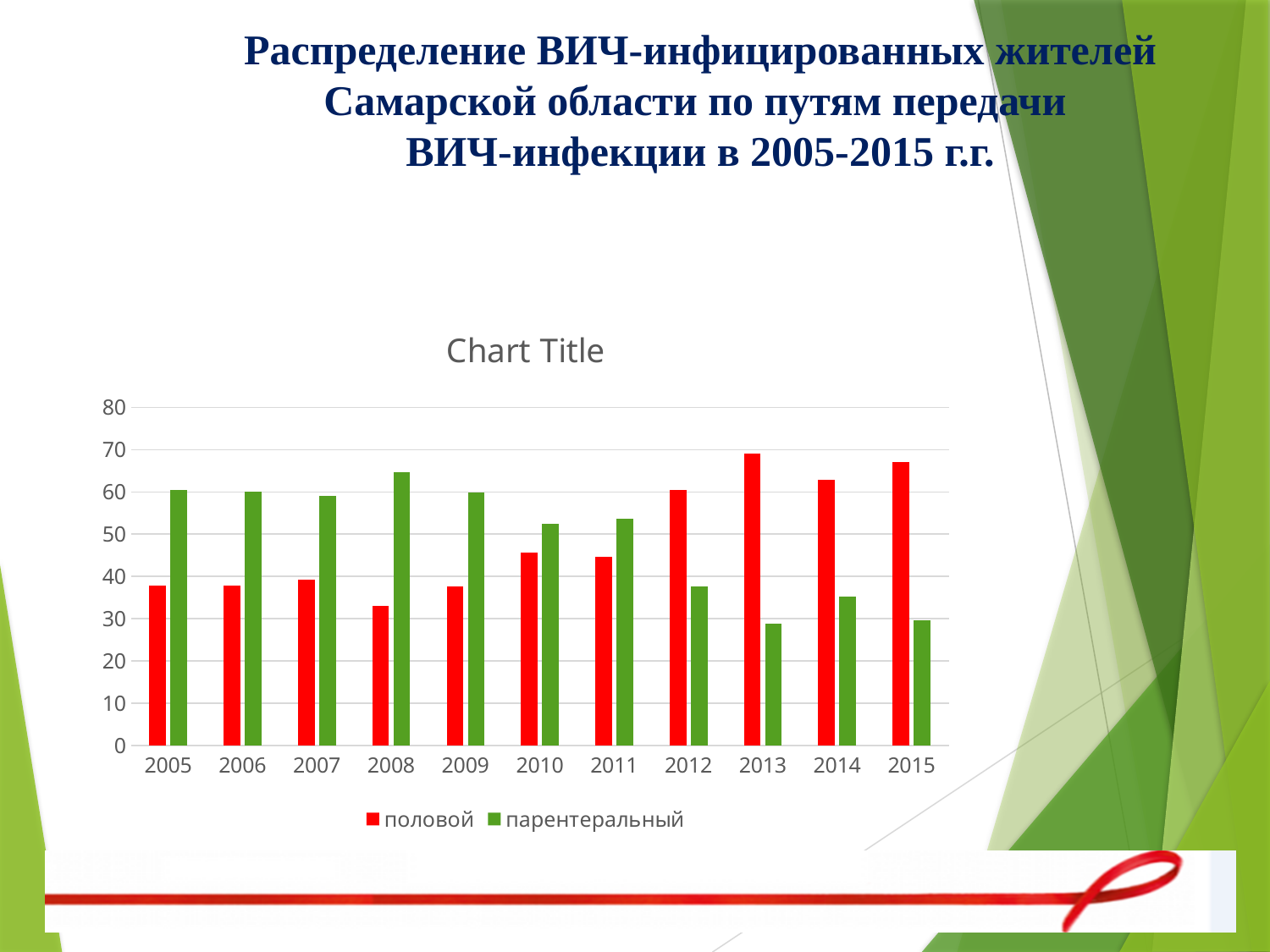
Is the value for половой in 2013 greater or less than 60? greater Is the value for парентеральный in 2012 greater or less than 40? less How many years are shown on the x axis? 11 In which year is the value for половой lowest? 2008 In 2013, which series has the larger value, половой or парентеральный? половой Is the value for парентеральный in 2008 greater or less than 60? greater What kind of chart is shown on the slide? bar chart Which series is shown in red in the legend? половой In 2005, which series has the larger value, половой or парентеральный? парентеральный Does the value for парентеральный generally rise or fall from 2005 to 2015? fall How many series does the legend list? 2